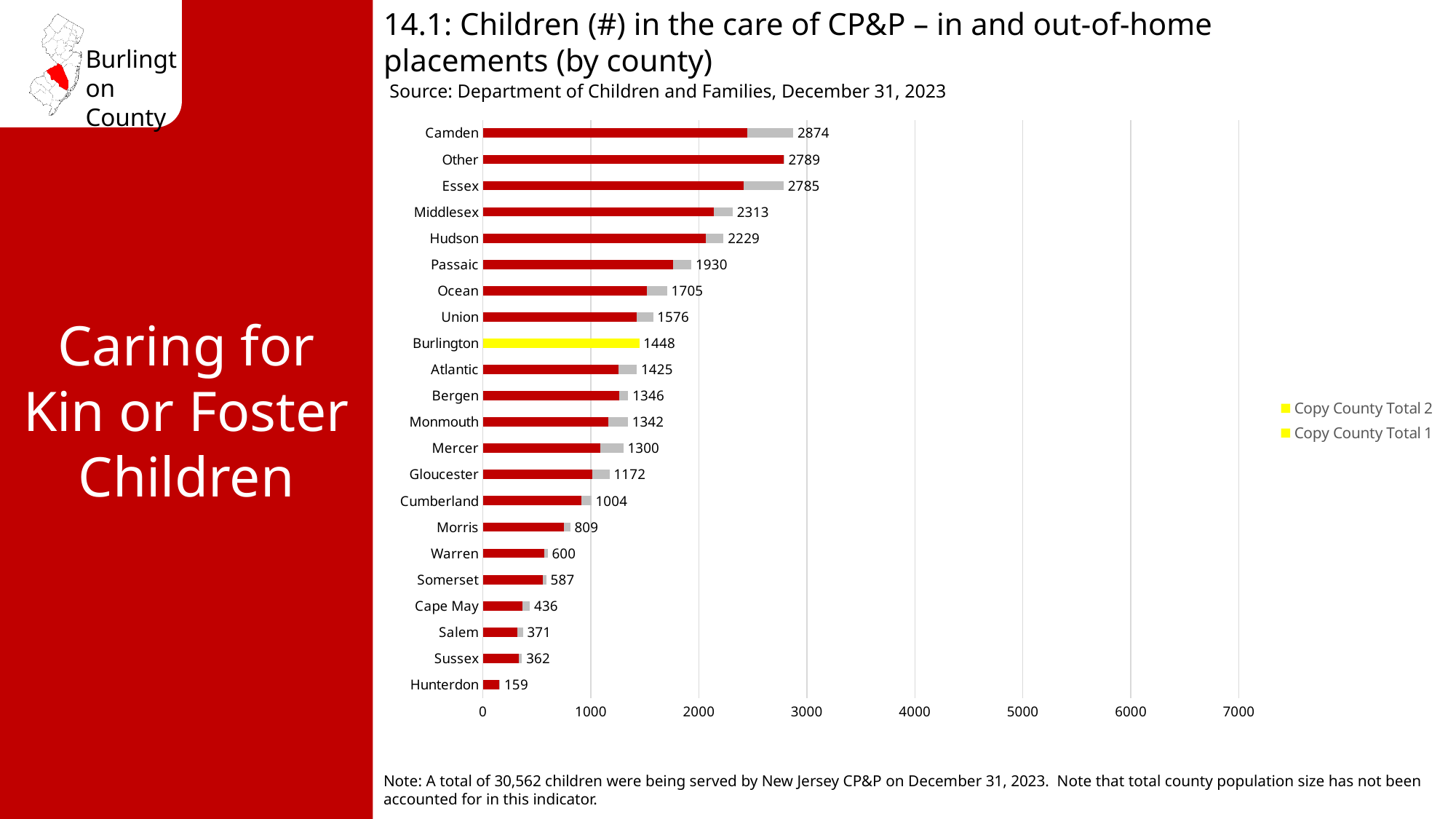
Which county has the highest number of children in the care of CP&P? Camden What kind of chart is shown on the slide? Bar chart Is the value for Middlesex greater or less than 2000? greater Which county has the lowest number of children in the care of CP&P? Hunterdon How many counties (categories) are shown on the chart? 22 Which has a larger value, Passaic or Ocean? Passaic How many series does the legend list? 2 What is the value shown for Hunterdon? 159 What is the difference between the values for Burlington and Atlantic? 23 What is the value shown for Burlington? 1448 What is the difference between the values for Camden and Essex? 89 What is the total number of children in the care of CP&P for Camden? 2874